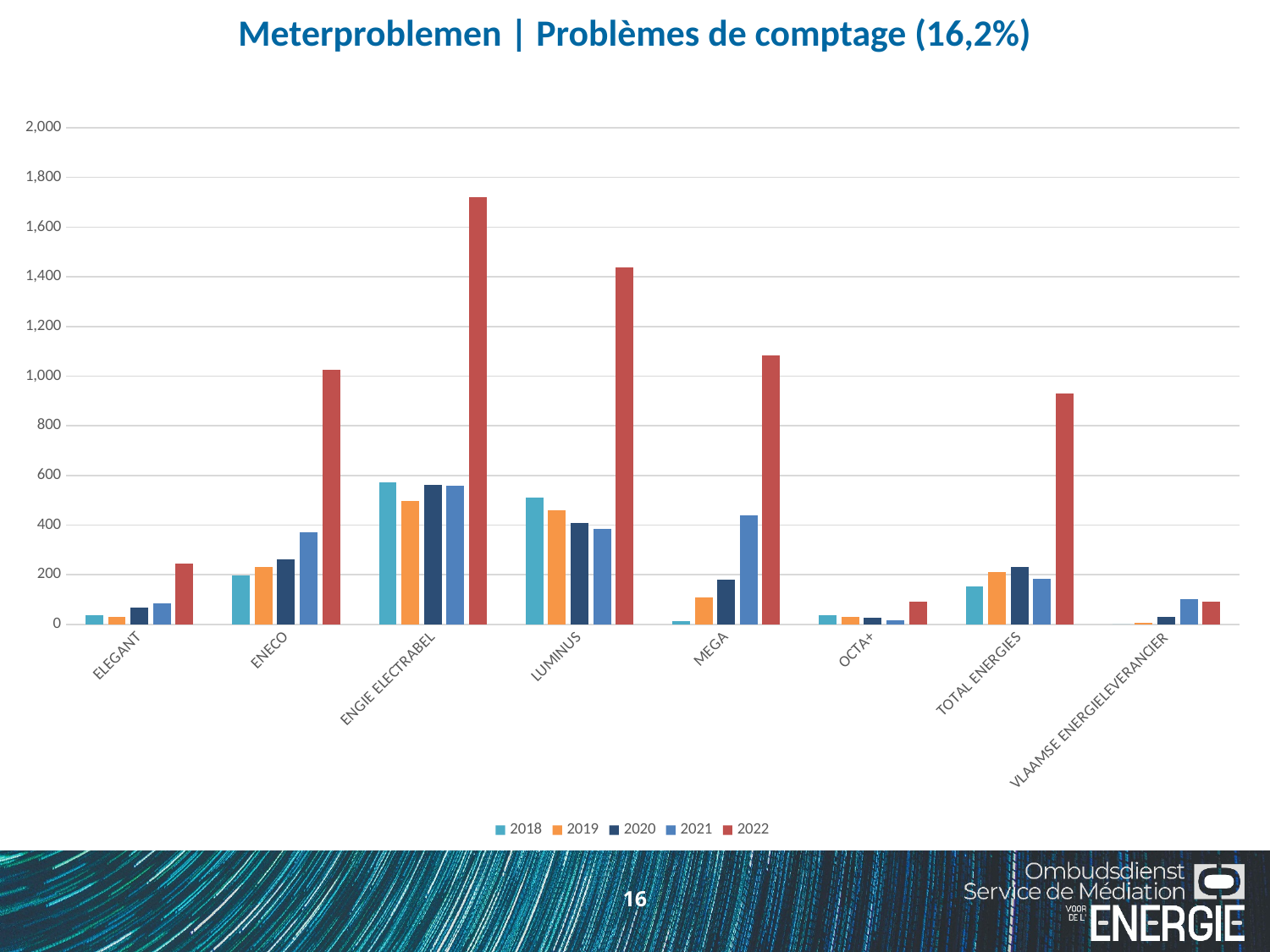
How many series does the legend list? 5 Which is larger, the 2022 value for LUMINUS or the 2022 value for MEGA? LUMINUS Which supplier has the highest 2022 bar? ENGIE ELECTRABEL Is the 2022 value for LUMINUS greater or less than 1,200? greater Is the 2022 value for TOTAL ENERGIES greater or less than 1,000? less Is the 2022 value for ENGIE ELECTRABEL greater or less than 1,600? greater What is the percentage shown in the chart title? 16,2% What kind of chart is shown on the slide? bar chart Which supplier has the highest 2018 bar? ENGIE ELECTRABEL How many supplier categories are shown on the x axis? 8 Do the values for ELEGANT rise or fall from 2018 to 2022? rise